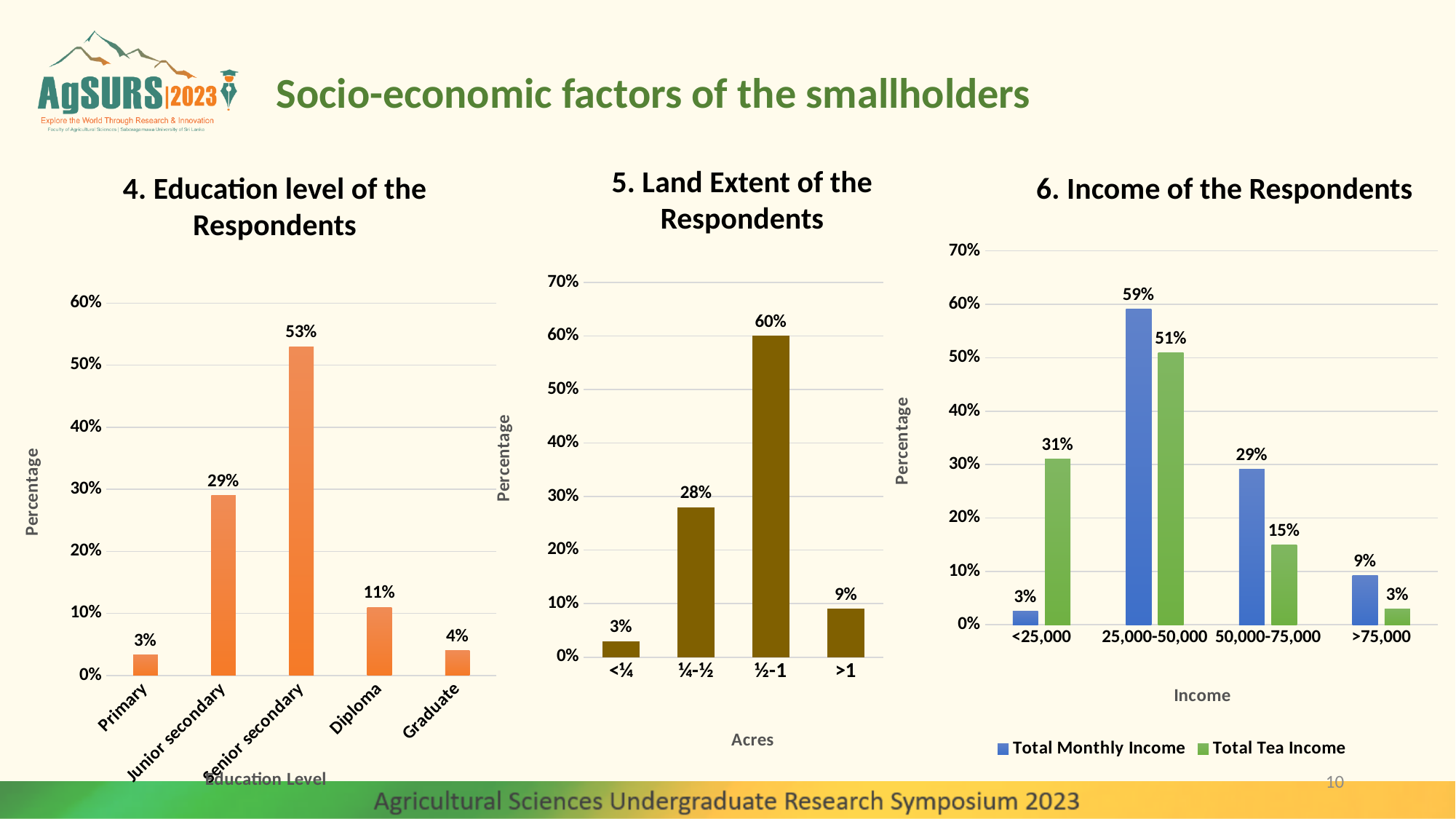
In the 'Income of the Respondents' chart, what is the difference between Total Monthly Income and Total Tea Income for the 25,000-50,000 category? 8% In the 'Education level of the Respondents' chart, what percentage of respondents have Senior secondary education? 53% In the 'Income of the Respondents' chart, what is the Total Tea Income value for the <25,000 category? 31% How many series does the legend of the 'Income of the Respondents' chart list? 2 How many education level categories are shown in the 'Education level of the Respondents' chart? 5 In the 'Education level of the Respondents' chart, which education level has the lowest percentage? Primary In the 'Land Extent of the Respondents' chart, which is larger: ¼-½ or >1? ¼-½ In the 'Education level of the Respondents' chart, what is the difference between Junior secondary and Diploma? 18% What type of chart is the 'Land Extent of the Respondents' chart? Bar chart In the 'Land Extent of the Respondents' chart, what percentage of respondents have ½-1 acres? 60% In the 'Income of the Respondents' chart, which series is shown in green? Total Tea Income In the 'Land Extent of the Respondents' chart, which land extent category has the highest percentage? ½-1